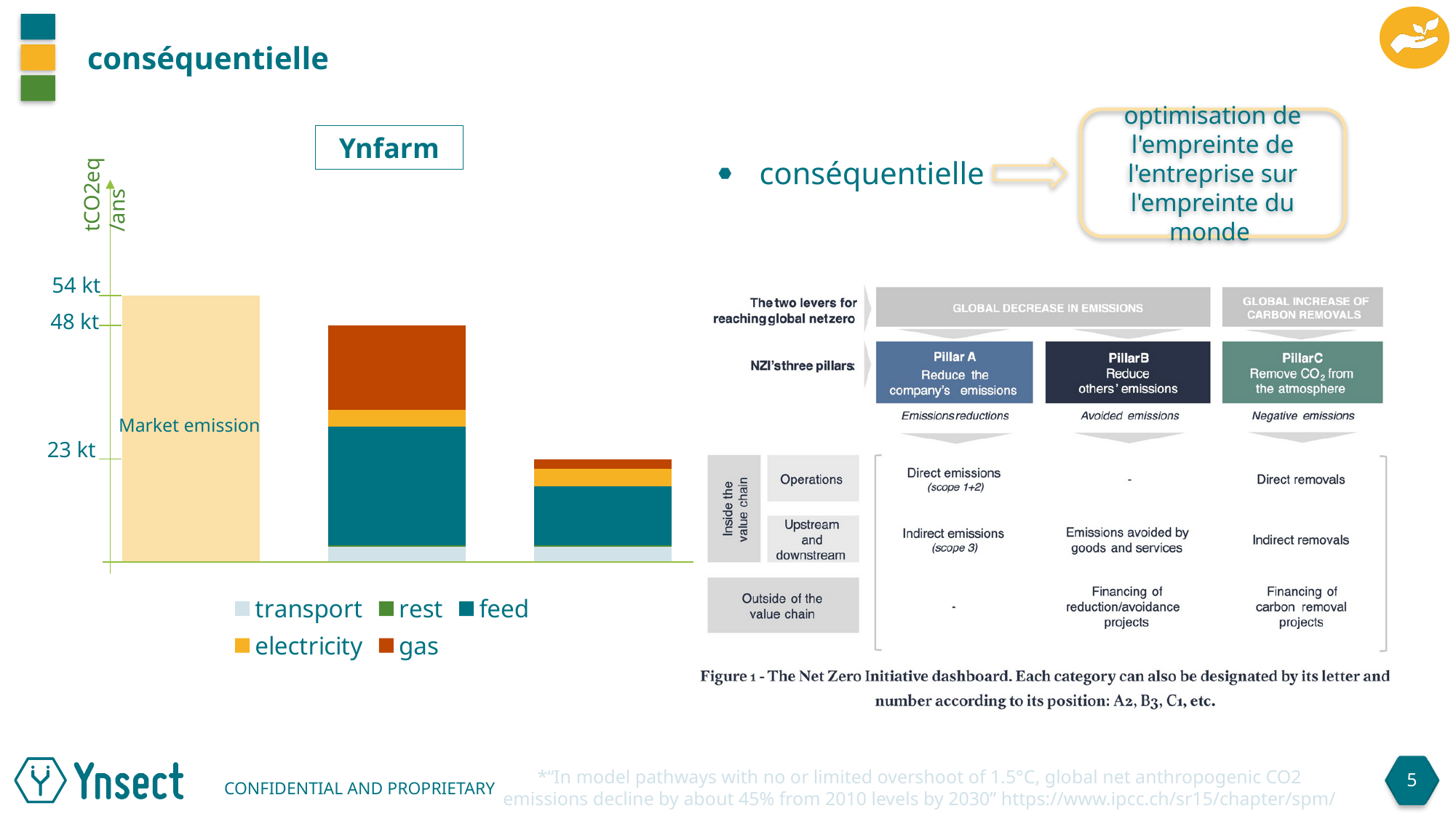
How many series does the legend of the Ynfarm chart list? 5 Which bar in the Ynfarm chart is the tallest? Market emission What is the title of the chart on the left of the slide? Ynfarm What kind of chart is the Ynfarm chart? bar chart In the Ynfarm chart, what is the difference between the Market emission bar and the middle stacked bar? 6 kt In the Ynfarm chart, what is the total height of the rightmost stacked bar? 23 kt How many bars are plotted in the Ynfarm chart? 3 In the Ynfarm chart, what value does the Market emission bar reach? 54 kt Which bar in the Ynfarm chart is the shortest? the rightmost bar Do the bar totals in the Ynfarm chart rise or fall from left to right? fall In the Ynfarm chart, what is the difference between the middle stacked bar and the rightmost stacked bar? 25 kt In the Ynfarm chart, what is the total height of the middle stacked bar? 48 kt